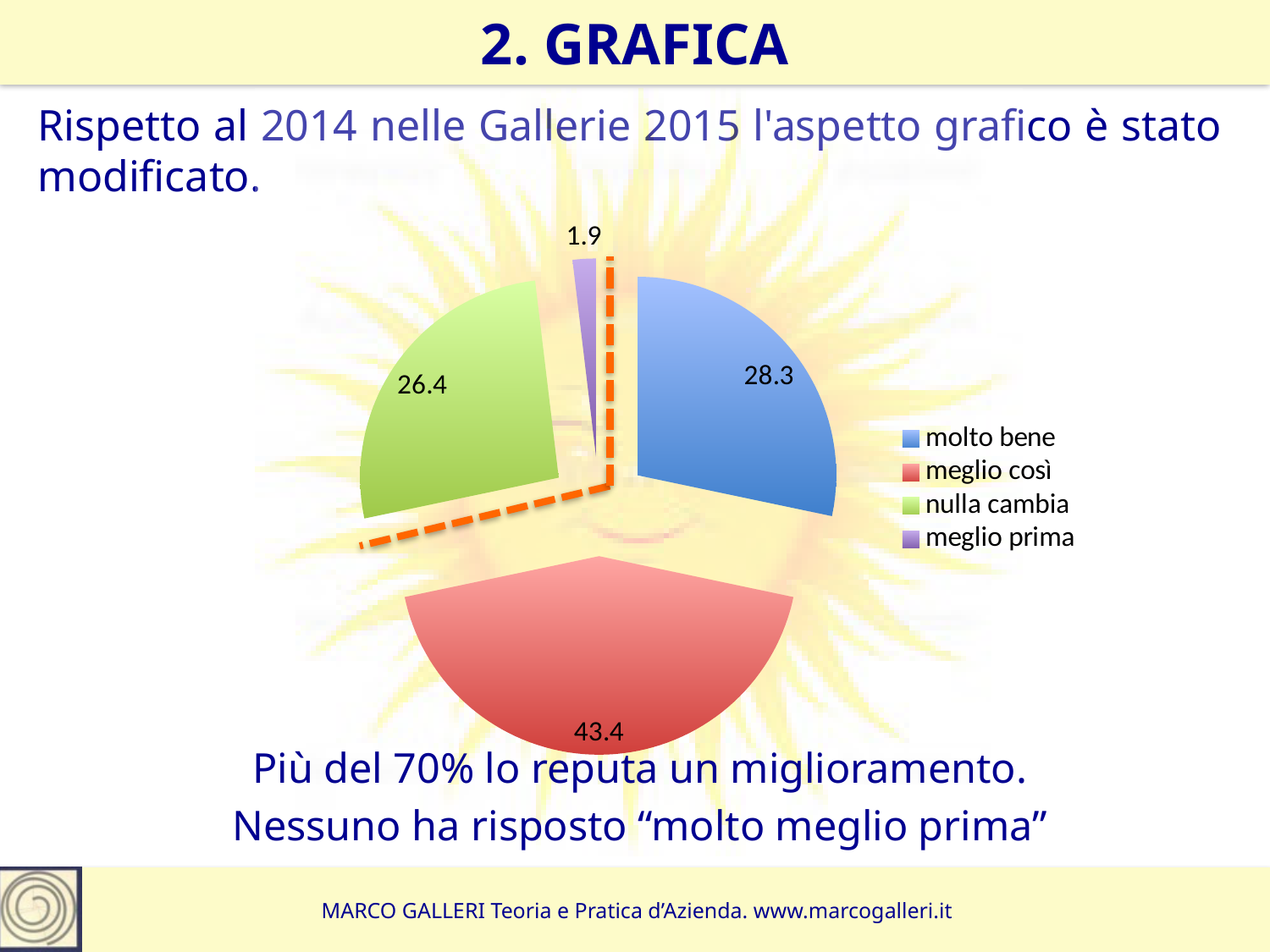
Which category has the smallest slice in the pie chart? meglio prima How many slices does the pie chart have? 4 Which is larger, the value for "molto bene" or the value for "nulla cambia"? molto bene What value is shown for the "meglio prima" slice of the pie chart? 1.9 Which category has the largest slice in the pie chart? meglio così What value is shown for the "meglio così" slice of the pie chart? 43.4 What is the difference between the values for "meglio così" and "molto bene"? 15.1 What value is shown for the "molto bene" slice of the pie chart? 28.3 What colour is the "nulla cambia" slice in the pie chart? green How many entries does the legend list? 4 What kind of chart is shown on the slide? pie chart What value is shown for the "nulla cambia" slice of the pie chart? 26.4